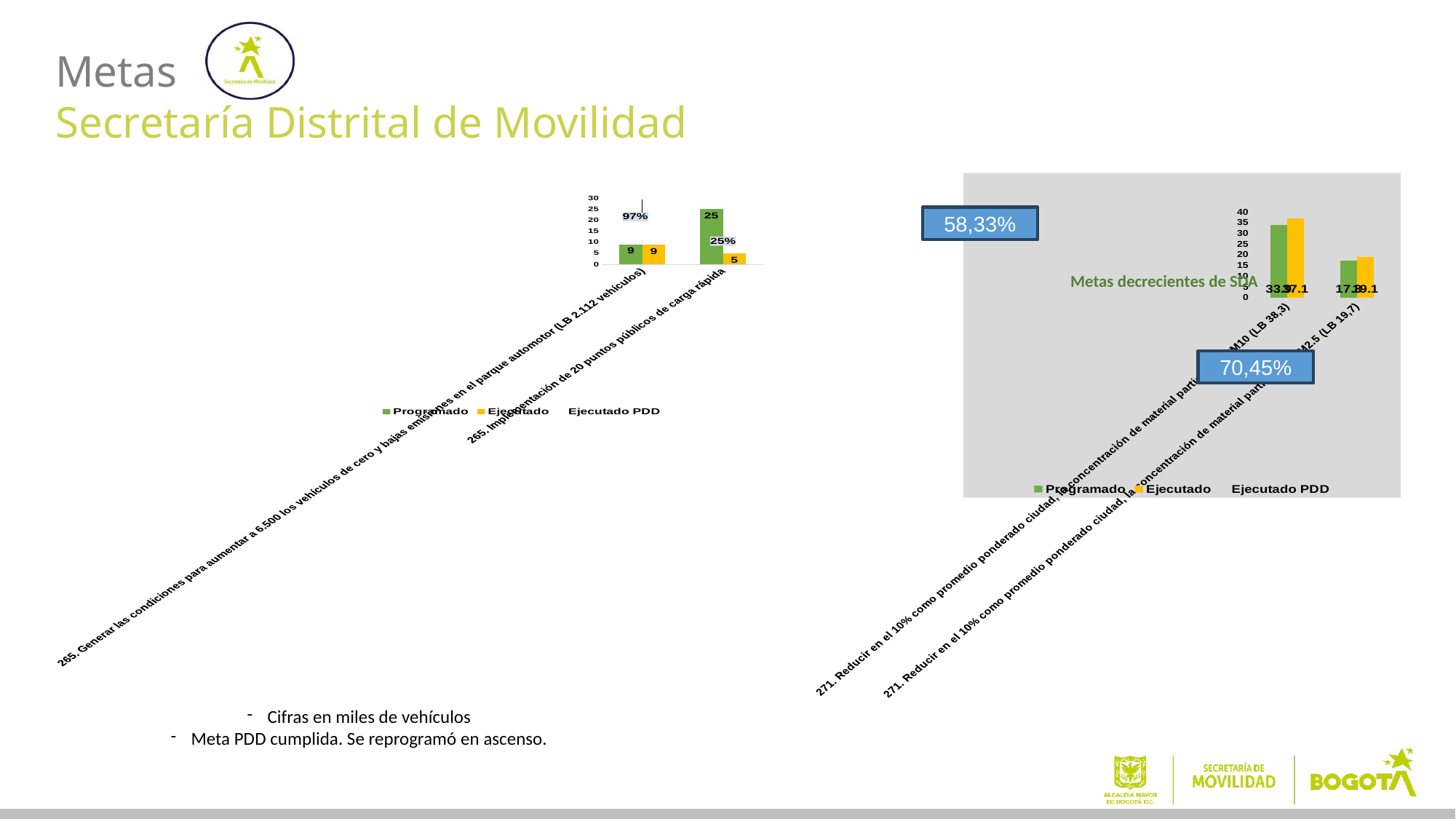
In the left chart, which is larger for '265. Implementación de 20 puntos públicos de carga rápida': the Programado value or the Ejecutado value? Programado How many categories are shown on the x axis of the 'Metas decrecientes de SDA' chart? 2 In the left chart, what is the Programado value for the category '265. Generar las condiciones para aumentar a 6.500 los vehículos de cero y bajas emisiones en el parque automotor (LB 2.112 vehículos)'? 9 In the left chart, what is the Programado value for the category '265. Implementación de 20 puntos públicos de carga rápida'? 25 In the 'Metas decrecientes de SDA' chart, which category has the higher Ejecutado value: PM10 (LB 38,3) or PM2.5 (LB 19,7)? PM10 (LB 38,3) How many series does the legend of the left chart list? 3 What kind of chart is the left chart? Bar chart In the 'Metas decrecientes de SDA' chart, what is the Ejecutado value for the PM10 (LB 38,3) category? 37.1 In the 'Metas decrecientes de SDA' chart, is the Programado value for the PM10 (LB 38,3) category greater or less than 30? greater In the left chart, what is the difference between the Programado and Ejecutado values for '265. Implementación de 20 puntos públicos de carga rápida'? 20 In the left chart, what is the Ejecutado value for the category '265. Implementación de 20 puntos públicos de carga rápida'? 5 In the 'Metas decrecientes de SDA' chart, what is the Ejecutado value for the PM2.5 (LB 19,7) category? 19.1